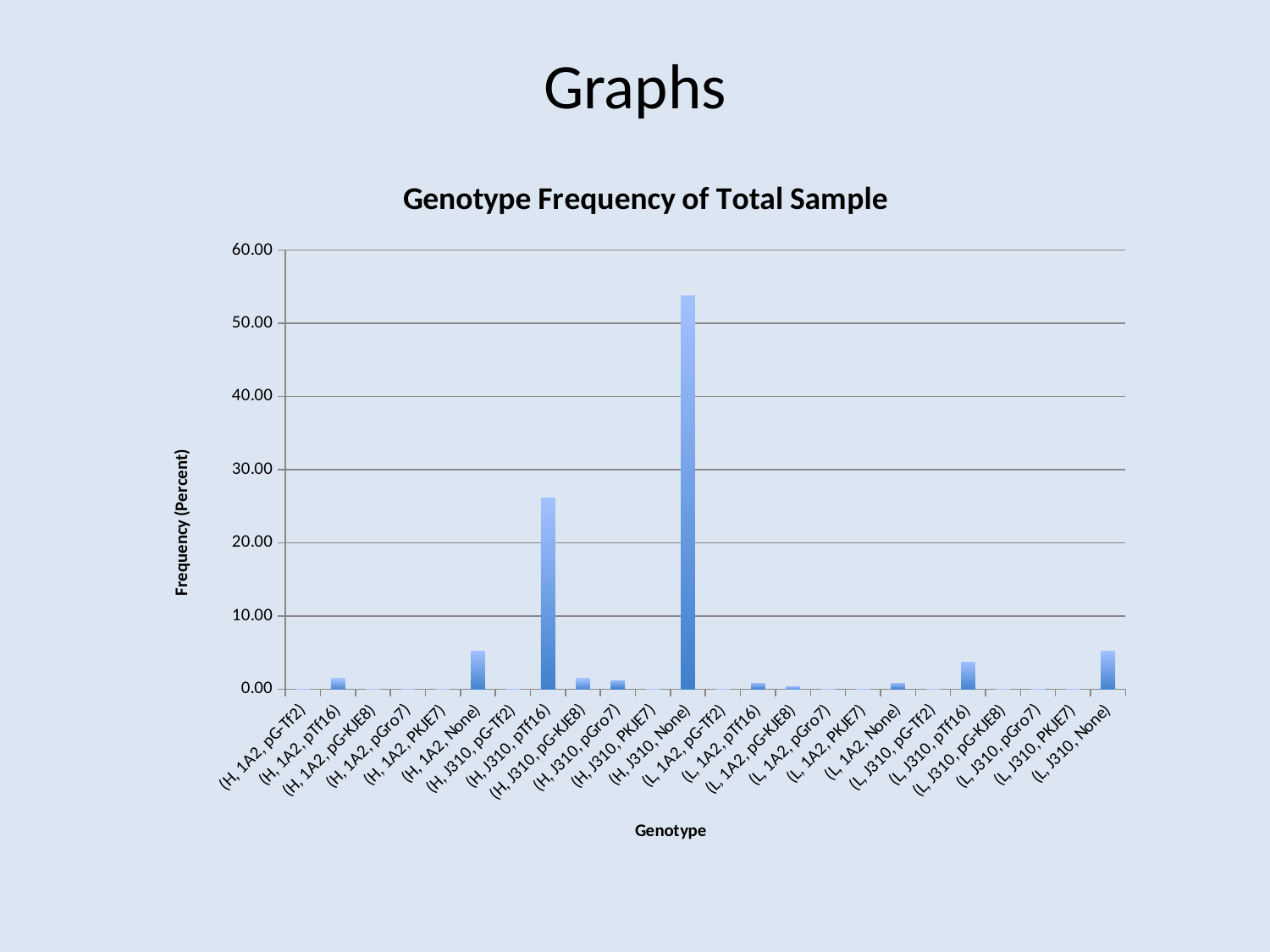
What is the title of the chart? Genotype Frequency of Total Sample Which has a higher frequency, (H, J310, pTf16) or (L, J310, None)? (H, J310, pTf16) Is the value for (H, J310, pTf16) greater or less than 20? greater What is the label of the vertical axis? Frequency (Percent) What type of chart is shown on the slide? bar chart Which has a higher frequency, (H, J310, None) or (H, J310, pTf16)? (H, J310, None) Is the value for (H, J310, pTf16) greater or less than 30? less Is the value for (H, 1A2, None) greater or less than 10? less Which genotype has the highest frequency? (H, J310, None) How many genotype categories are plotted on the x axis? 24